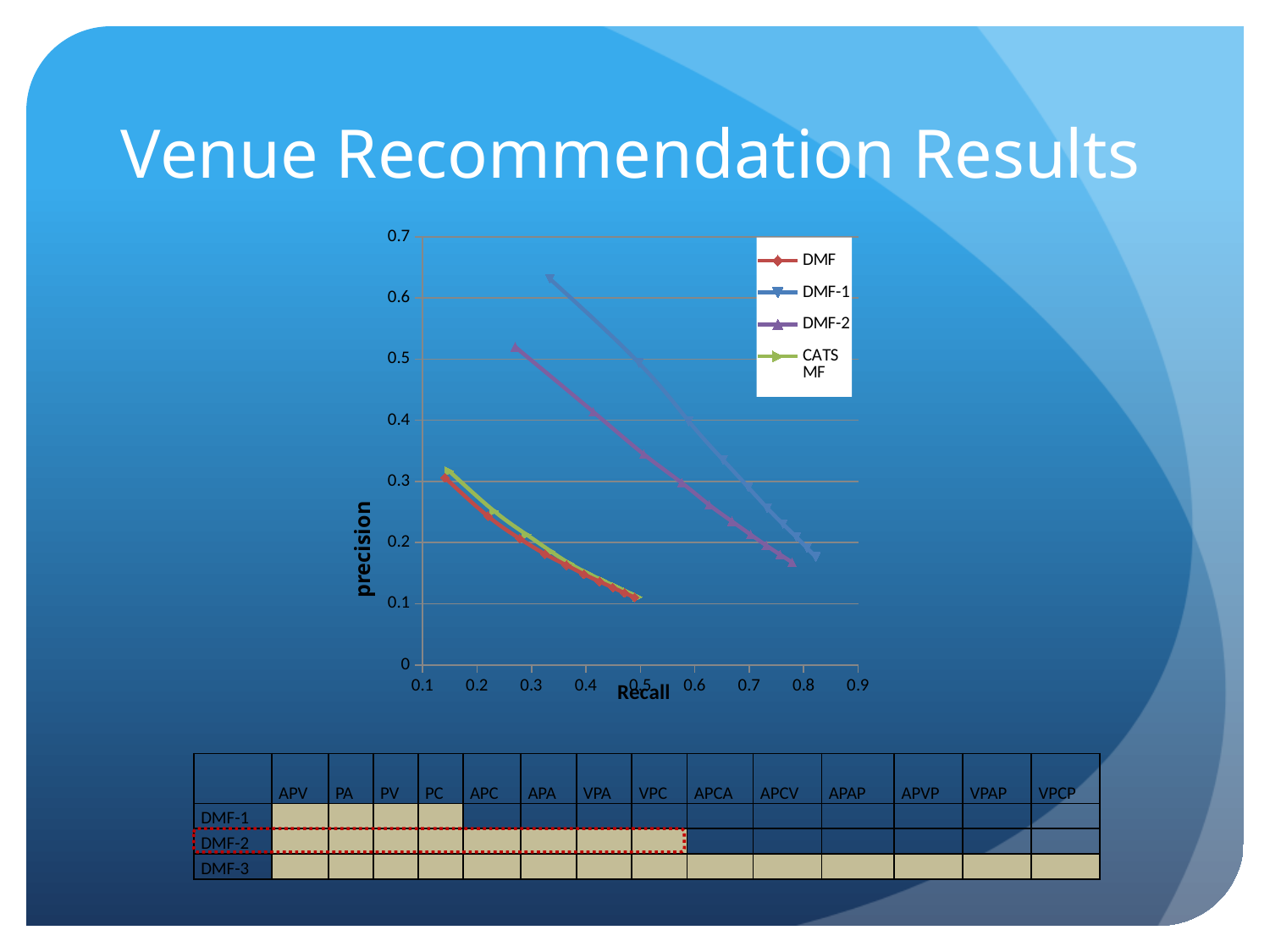
Is the highest precision value of the DMF-2 series greater or less than 0.4? greater How many series does the chart's legend list? 4 Which series reaches a higher maximum precision, DMF or DMF-2? DMF-2 What is the label of the vertical axis of the chart? precision What kind of chart is shown on the slide? line chart As recall increases along the x axis, does precision rise or fall for the series on the chart? fall Is the highest precision value of the DMF-1 series greater or less than 0.6? greater Which series extends to the highest recall value on the chart? DMF-1 Is the lowest precision value of the DMF-1 series greater or less than 0.2? less Which series reaches the highest precision value on the chart? DMF-1 At a recall of 0.5, which series has the higher precision, DMF-1 or DMF-2? DMF-1 What is the label of the horizontal axis of the chart? Recall